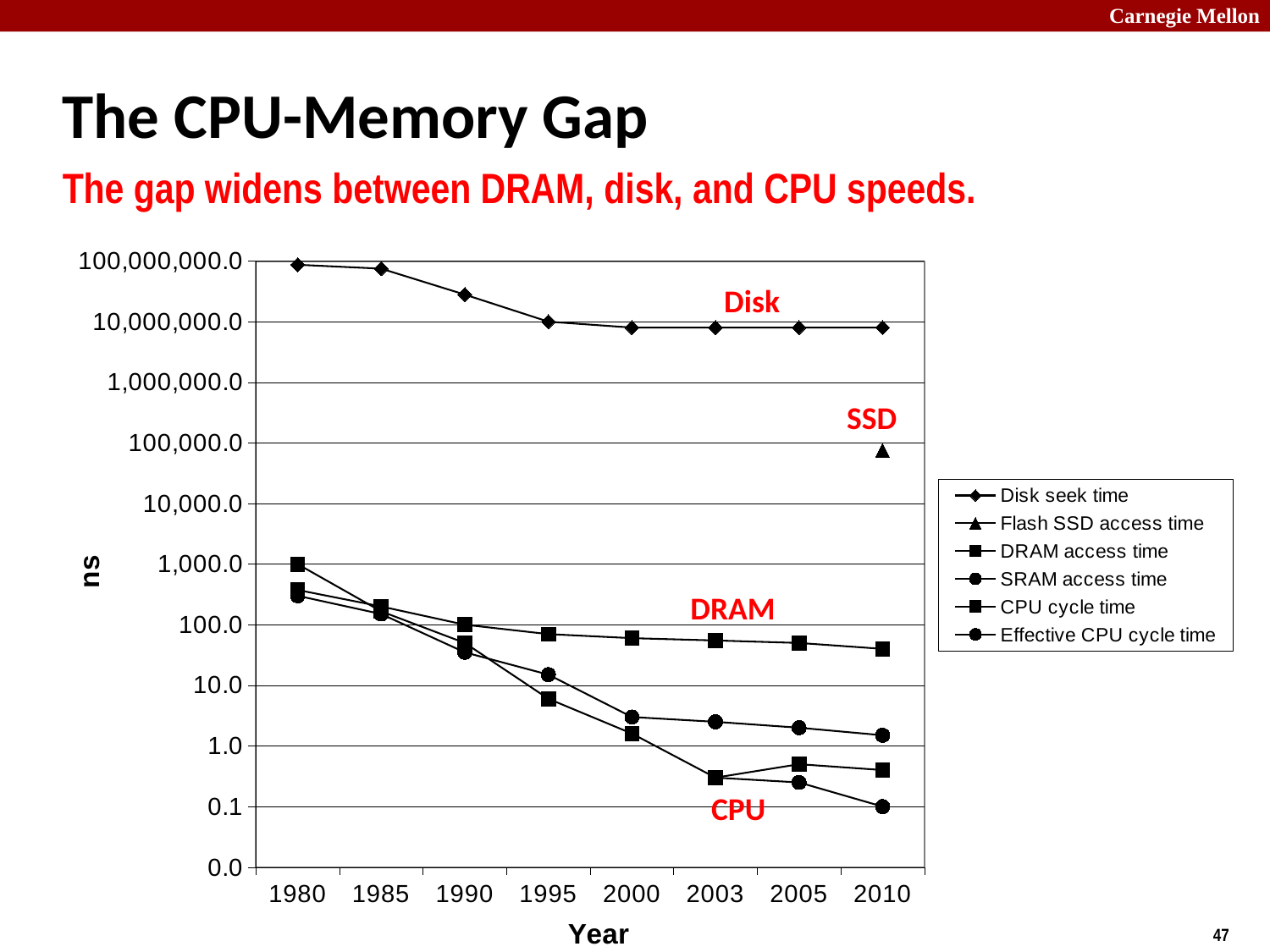
Which series has the lowest value in 2010? Effective CPU cycle time How many series does the legend list? 6 Does the Disk seek time rise or fall from 1980 to 2010? fall What is the DRAM access time value in 1990? 100.0 What is the CPU cycle time value in 1980? 1,000.0 How many years are marked along the x axis? 8 What is the Disk seek time value in 1995? 10,000,000.0 What is the Effective CPU cycle time value in 2010? 0.1 In 2010, which is larger: DRAM access time or SRAM access time? DRAM access time What kind of chart is shown on the slide? line chart Which series has the highest value in 2010? Disk seek time Is the Flash SSD access time value in 2010 greater or less than 100,000.0? less